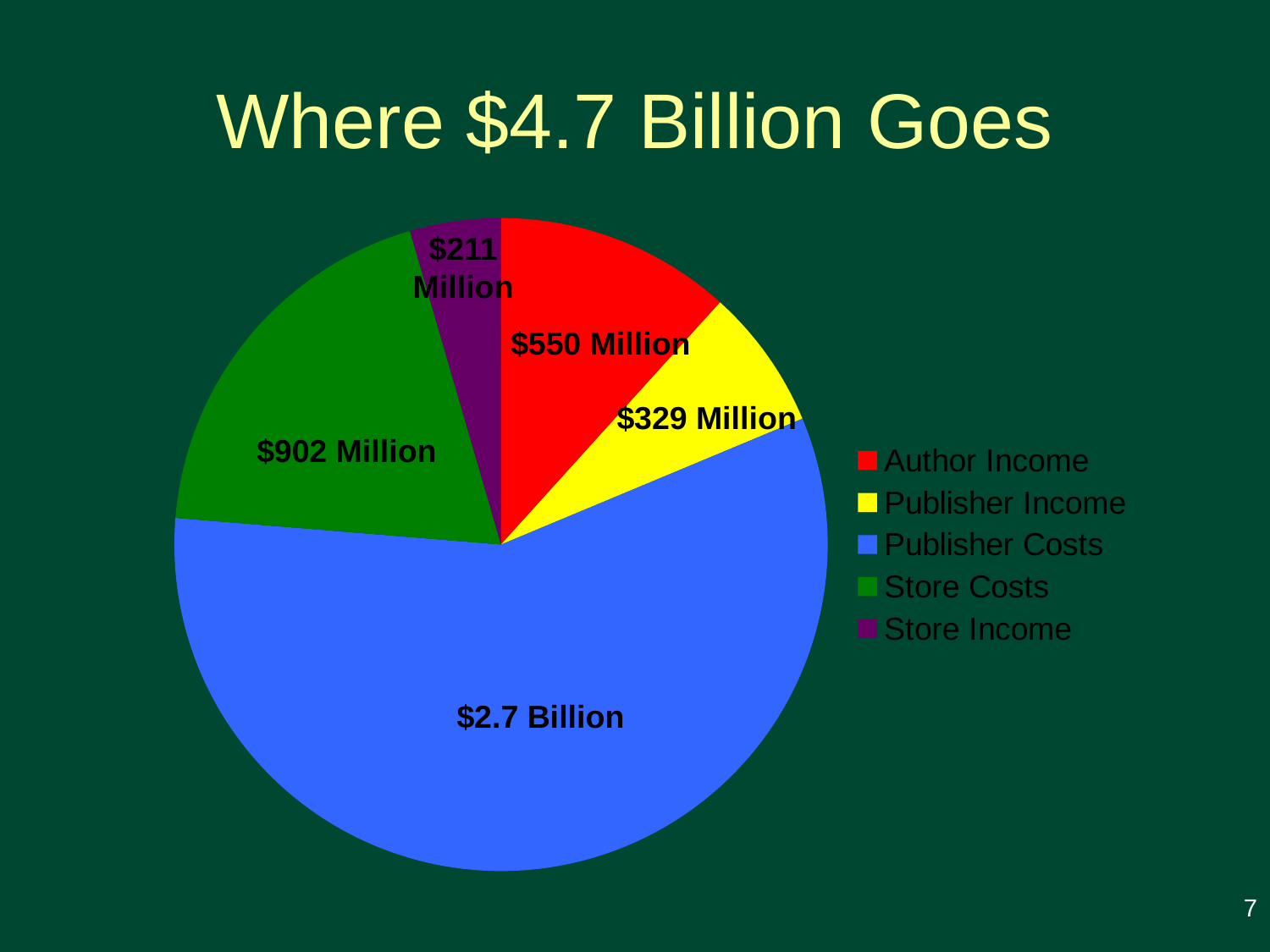
Which category has the largest slice of the pie? Publisher Costs What is the title of the chart? Where $4.7 Billion Goes How many categories does the legend list? 5 What is the value for Publisher Costs? $2.7 Billion What is the value for Store Income? $211 Million Which category has the smallest slice of the pie? Store Income What is the value for Publisher Income? $329 Million What is the value for Author Income? $550 Million Which is larger, Author Income or Publisher Income? Author Income What is the value for Store Costs? $902 Million What type of chart is shown on the slide? Pie chart What is the difference between Store Costs and Author Income? $352 Million